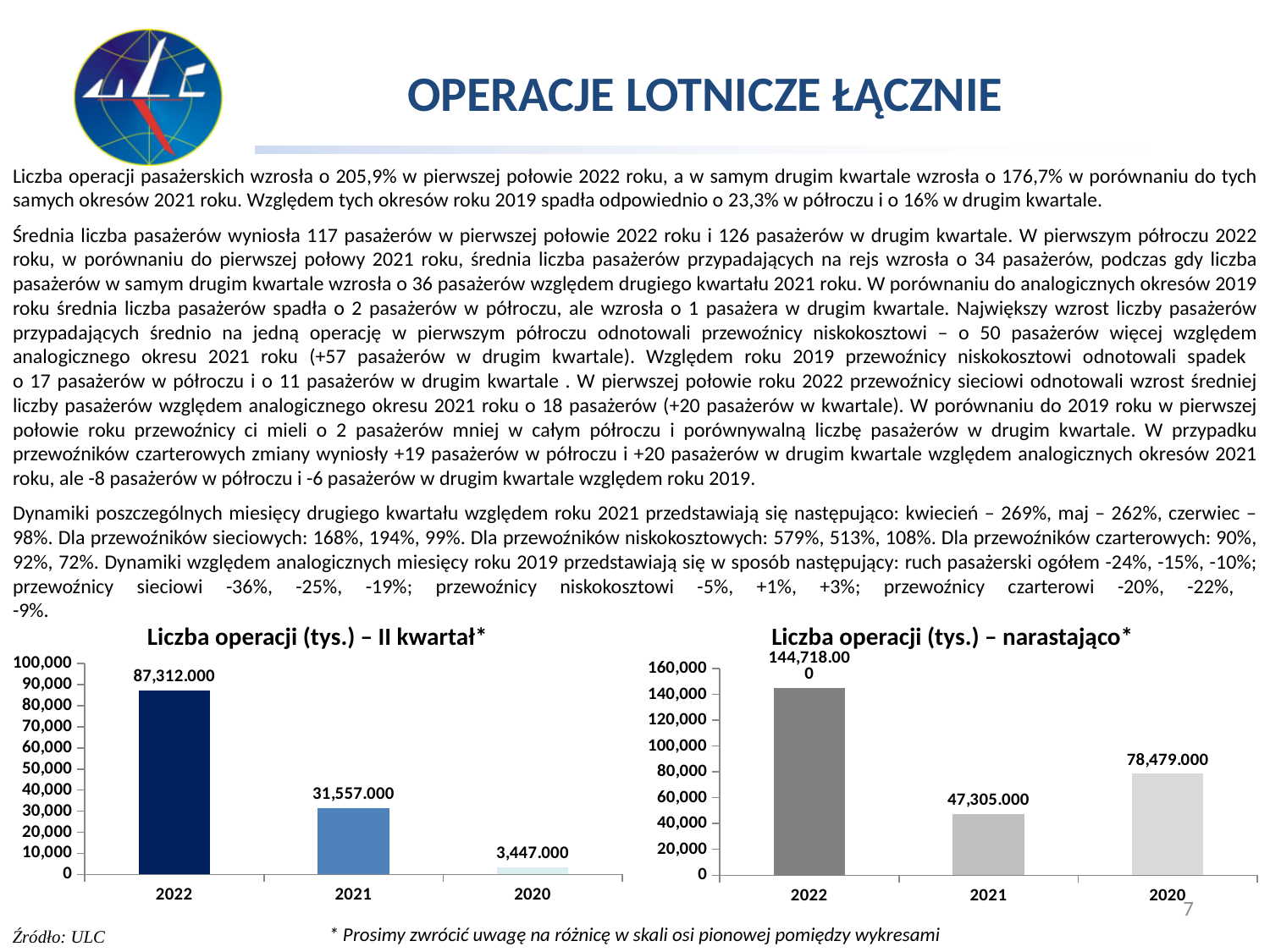
In the chart 'Liczba operacji (tys.) – narastająco*', what is the value for 2020? 78,479.000 In the chart 'Liczba operacji (tys.) – narastająco*', what is the value for 2021? 47,305.000 In the chart 'Liczba operacji (tys.) – II kwartał*', what is the difference between the values for 2022 and 2021? 55,755.000 In the chart 'Liczba operacji (tys.) – narastająco*', which is larger: the value for 2021 or the value for 2020? 2020 In the chart 'Liczba operacji (tys.) – II kwartał*', which year has the lowest value? 2020 In the chart 'Liczba operacji (tys.) – narastająco*', which year has the lowest value? 2021 In the chart 'Liczba operacji (tys.) – II kwartał*', what is the value for 2020? 3,447.000 How many bars are shown in the chart 'Liczba operacji (tys.) – II kwartał*'? 3 What type of chart is 'Liczba operacji (tys.) – narastająco*'? Bar chart In the chart 'Liczba operacji (tys.) – II kwartał*', what is the value for 2022? 87,312.000 In the chart 'Liczba operacji (tys.) – narastająco*', which year has the highest value? 2022 In the chart 'Liczba operacji (tys.) – narastająco*', what is the difference between the values for 2020 and 2021? 31,174.000